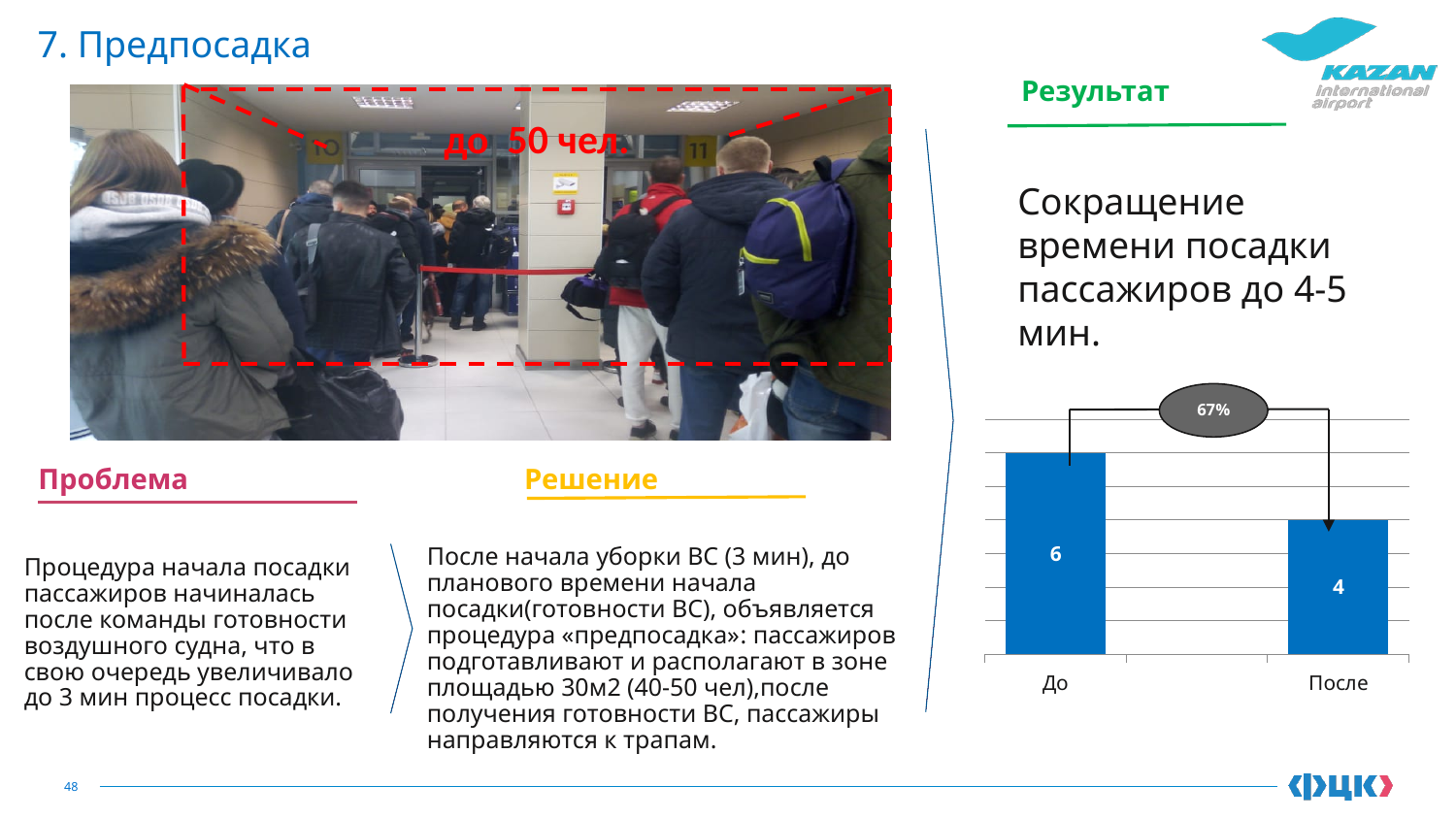
Which category has the lowest value in the bar chart? После What percentage is shown in the oval annotation above the bars? 67% Do the values rise or fall from "До" to "После"? fall What colour are the bars in the chart? blue What is the difference between the values for "До" and "После"? 2 Which category has the highest value in the bar chart? До What kind of chart is shown on the slide? bar chart What is the value for "До" in the bar chart? 6 How many categories are shown in the bar chart? 2 Which is larger, the value for "До" or the value for "После"? До What is the value for "После" in the bar chart? 4